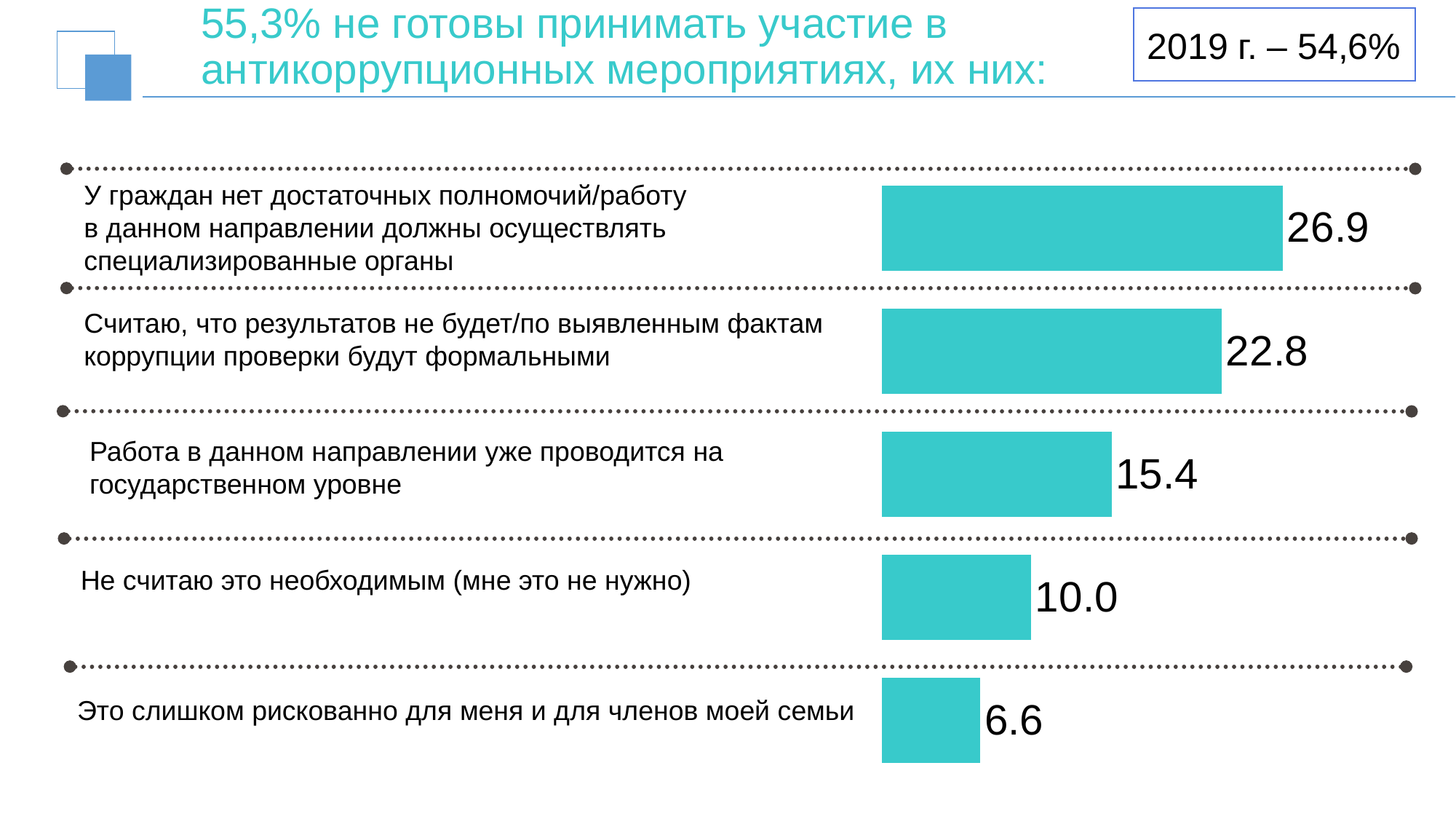
What value is shown for 'Считаю, что результатов не будет/по выявленным фактам коррупции проверки будут формальными'? 22.8 What percentage for 2019 is shown in the box at the top right of the slide? 54,6% Which is larger: the value for 'Работа в данном направлении уже проводится на государственном уровне' or for 'Не считаю это необходимым (мне это не нужно)'? Работа в данном направлении уже проводится на государственном уровне Which category has the lowest value? Это слишком рискованно для меня и для членов моей семьи What value is shown for 'Работа в данном направлении уже проводится на государственном уровне'? 15.4 How many categories are shown in the chart? 5 What value is shown for the category 'Не считаю это необходимым (мне это не нужно)'? 10.0 What value is shown for 'Это слишком рискованно для меня и для членов моей семьи'? 6.6 What is the difference between the values for 'У граждан нет достаточных полномочий...' (26.9) and 'Считаю, что результатов не будет...' (22.8)? 4.1 Which category has the highest value? У граждан нет достаточных полномочий/работу в данном направлении должны осуществлять специализированные органы What kind of chart is shown on the slide? Bar chart What is the difference between the values for 'Не считаю это необходимым' and 'Это слишком рискованно для меня и для членов моей семьи'? 3.4